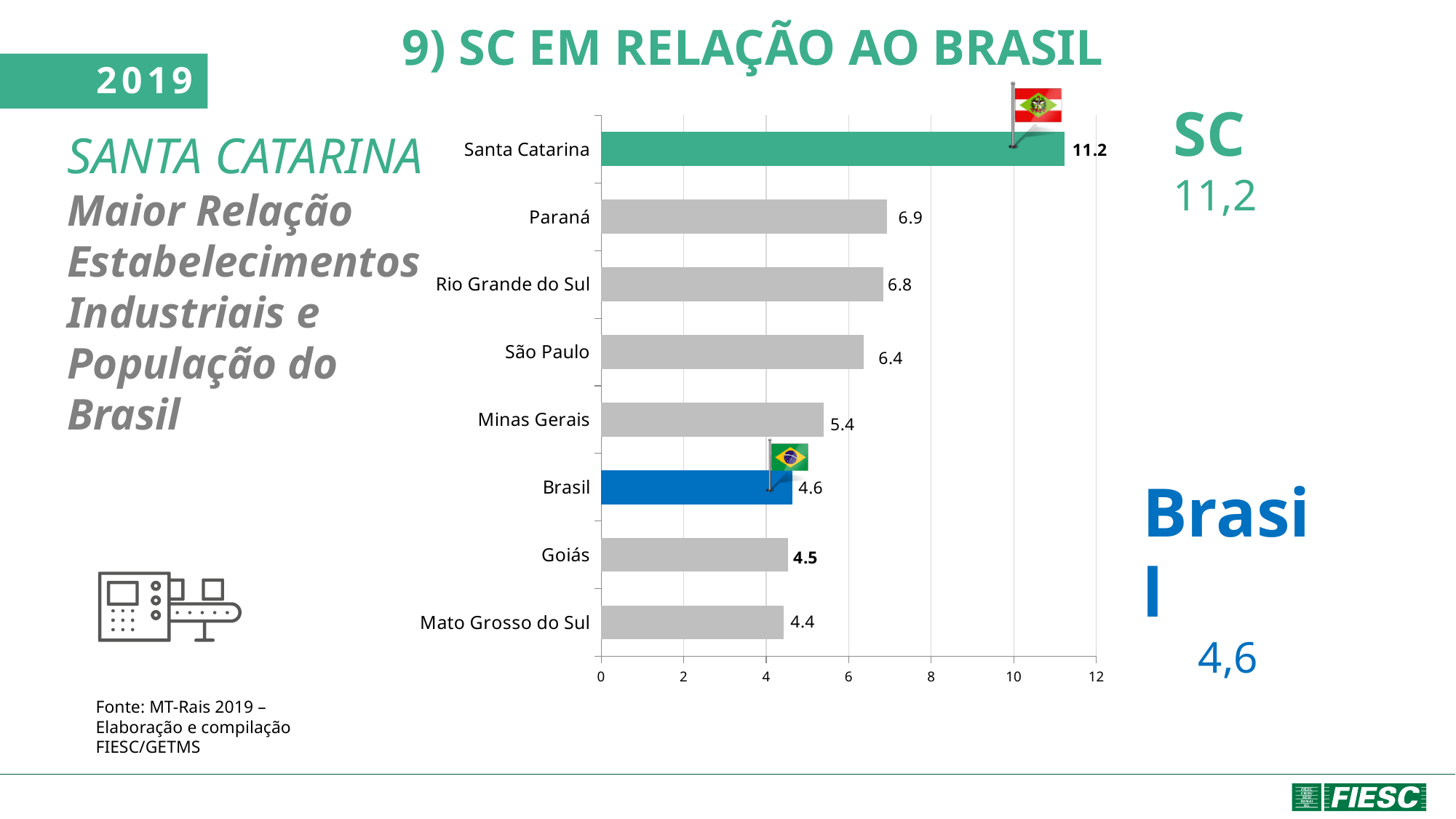
What is the difference between the values for Santa Catarina and Brasil? 6.6 What is the value for Minas Gerais? 5.4 What kind of chart is shown on the slide? Bar chart Which category has the lowest value? Mato Grosso do Sul What is the difference between the values for Paraná and São Paulo? 0.5 Which has a larger value, Paraná or Minas Gerais? Paraná Which category has the highest value? Santa Catarina What is the value for Santa Catarina? 11.2 What colour is the bar for Brasil? Blue What is the value for Mato Grosso do Sul? 4.4 How many categories are shown in the chart? 8 What is the value for Brasil? 4.6